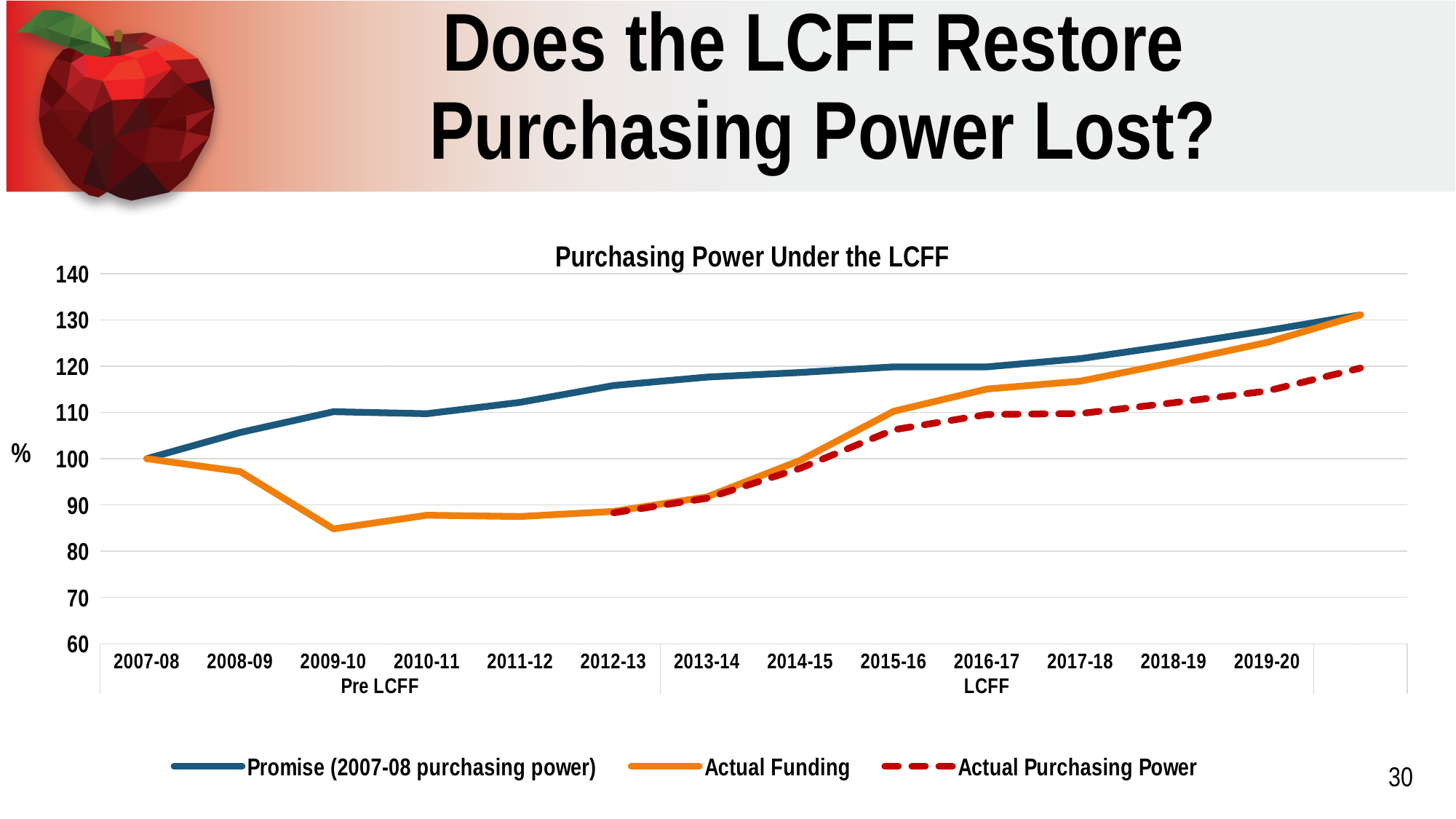
In 2012-13, which is larger: Promise (2007-08 purchasing power) or Actual Funding? Promise (2007-08 purchasing power) Is the Actual Funding value for 2008-09 greater or less than 100? less What kind of chart is shown on the slide? line chart What is the value of the Promise (2007-08 purchasing power) series in 2007-08? 100 Is the Promise (2007-08 purchasing power) value for 2012-13 greater or less than 110? greater How many fiscal years are plotted along the x axis? 13 Does the Promise (2007-08 purchasing power) series rise or fall from 2007-08 to 2019-20? rise Is the Actual Funding value for 2009-10 greater or less than 90? less In which year is Actual Funding at its lowest? 2009-10 How many series does the legend list? 3 What is the title of the chart? Purchasing Power Under the LCFF